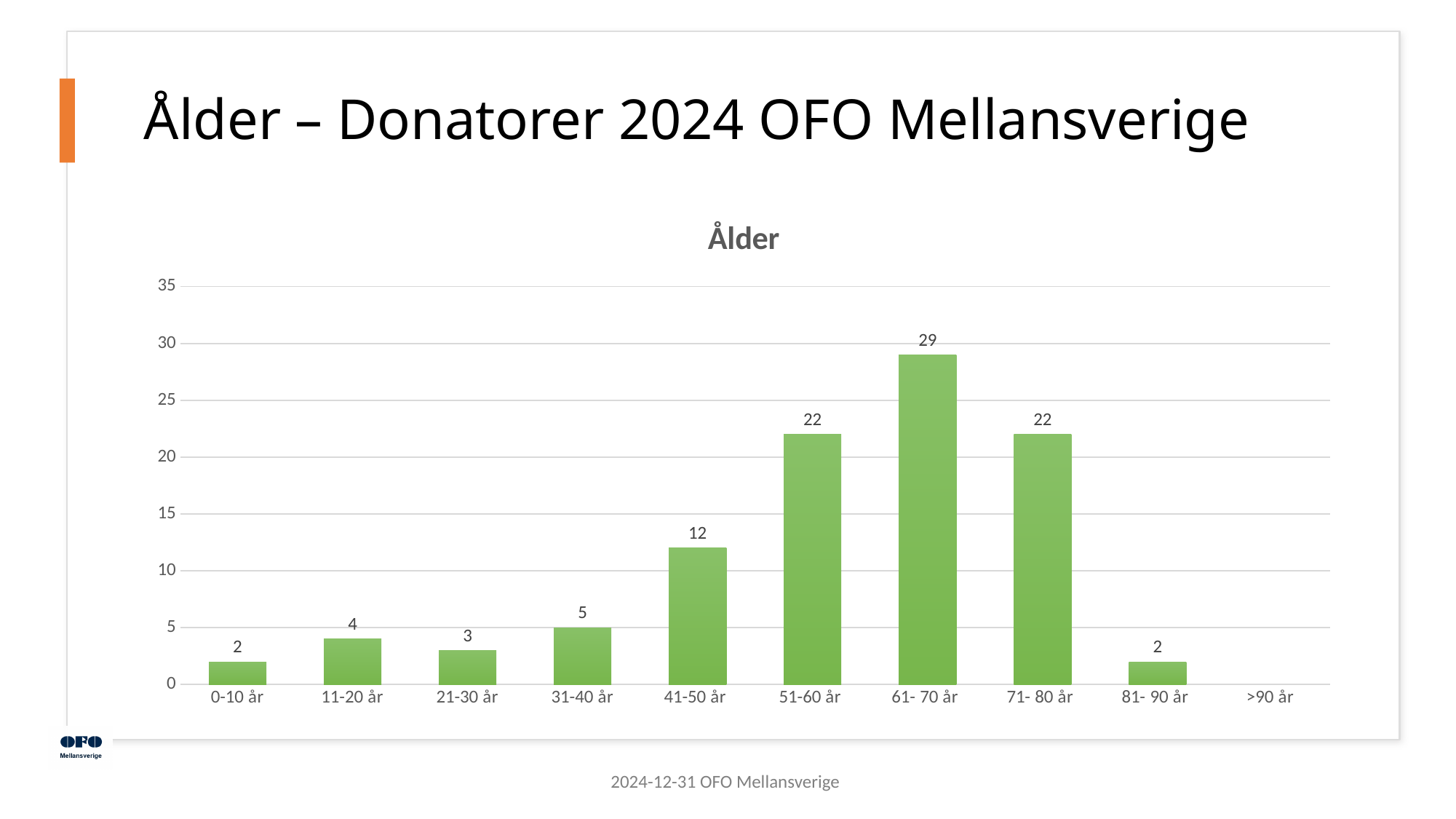
What is the value for the 61- 70 år category? 29 What is the value for the 41-50 år category? 12 Is the value for 71- 80 år greater or less than 20? greater What is the difference between the values for 61- 70 år and 51-60 år? 7 Which is larger, the value for 41-50 år or the value for 21-30 år? 41-50 år Which age category has the highest value? 61- 70 år What is the title of the chart? Ålder How many age categories are shown on the x axis? 10 What is the value for the 31-40 år category? 5 What colour are the bars in the chart? green What kind of chart is shown on the slide? bar chart Do the values rise or fall from 0-10 år to 61- 70 år? rise